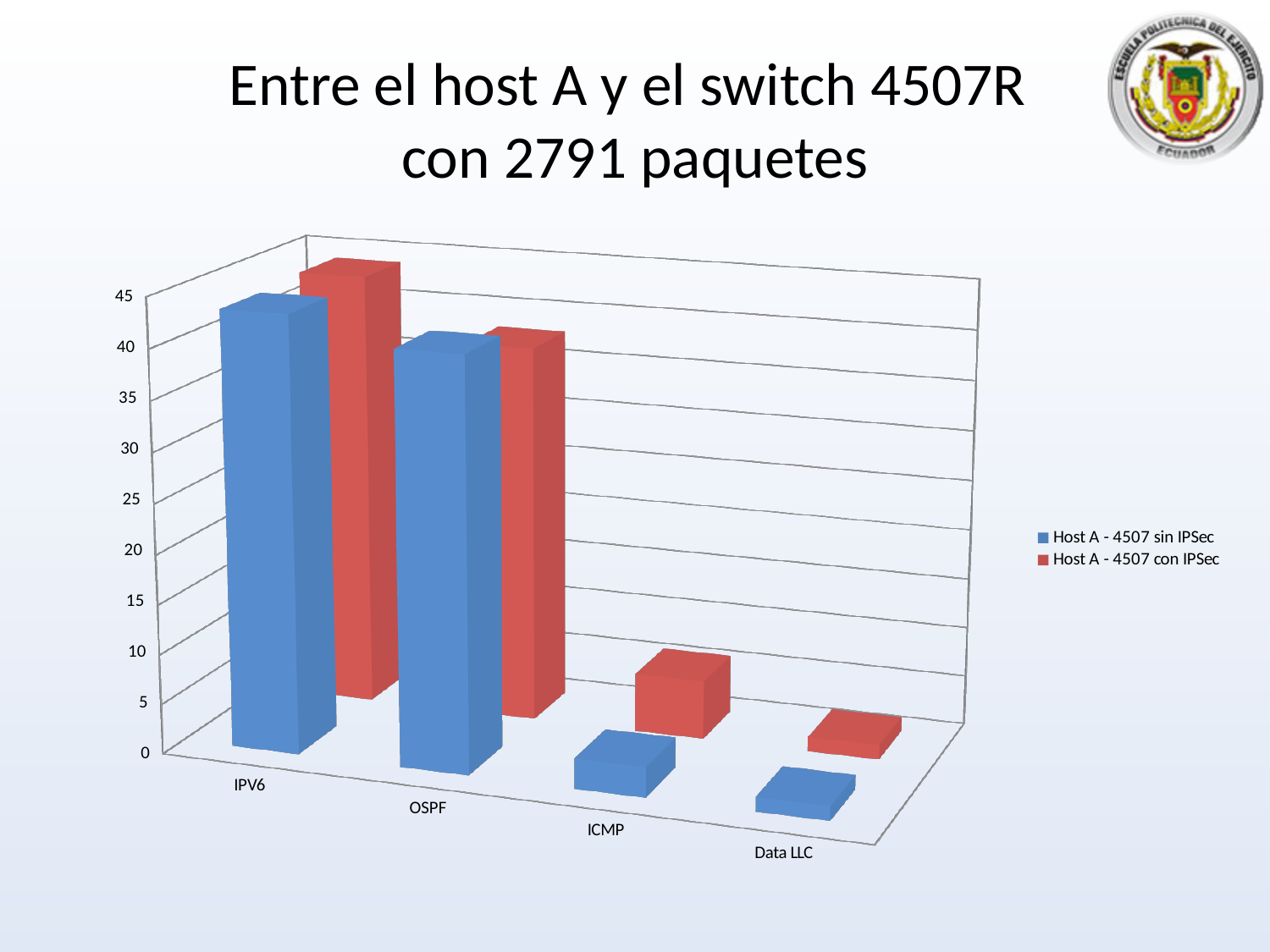
Is the value for ICMP in the 'Host A - 4507 sin IPSec' series greater or less than 10? less Which category has the lowest value for the 'Host A - 4507 con IPSec' series? Data LLC Which is larger in the 'Host A - 4507 sin IPSec' series, the value for IPV6 or the value for ICMP? IPV6 Is the value for IPV6 in the 'Host A - 4507 sin IPSec' series greater or less than 30? greater What kind of chart is shown on the slide? bar chart What is the title of the slide containing the chart? Entre el host A y el switch 4507R con 2791 paquetes Is the value for Data LLC in the 'Host A - 4507 con IPSec' series greater or less than 10? less Do the values in the 'Host A - 4507 sin IPSec' series rise or fall from IPV6 to Data LLC along the x axis? fall How many categories are shown on the x axis of the chart? 4 How many series does the chart's legend list? 2 Which category has the highest value for the 'Host A - 4507 sin IPSec' series? IPV6